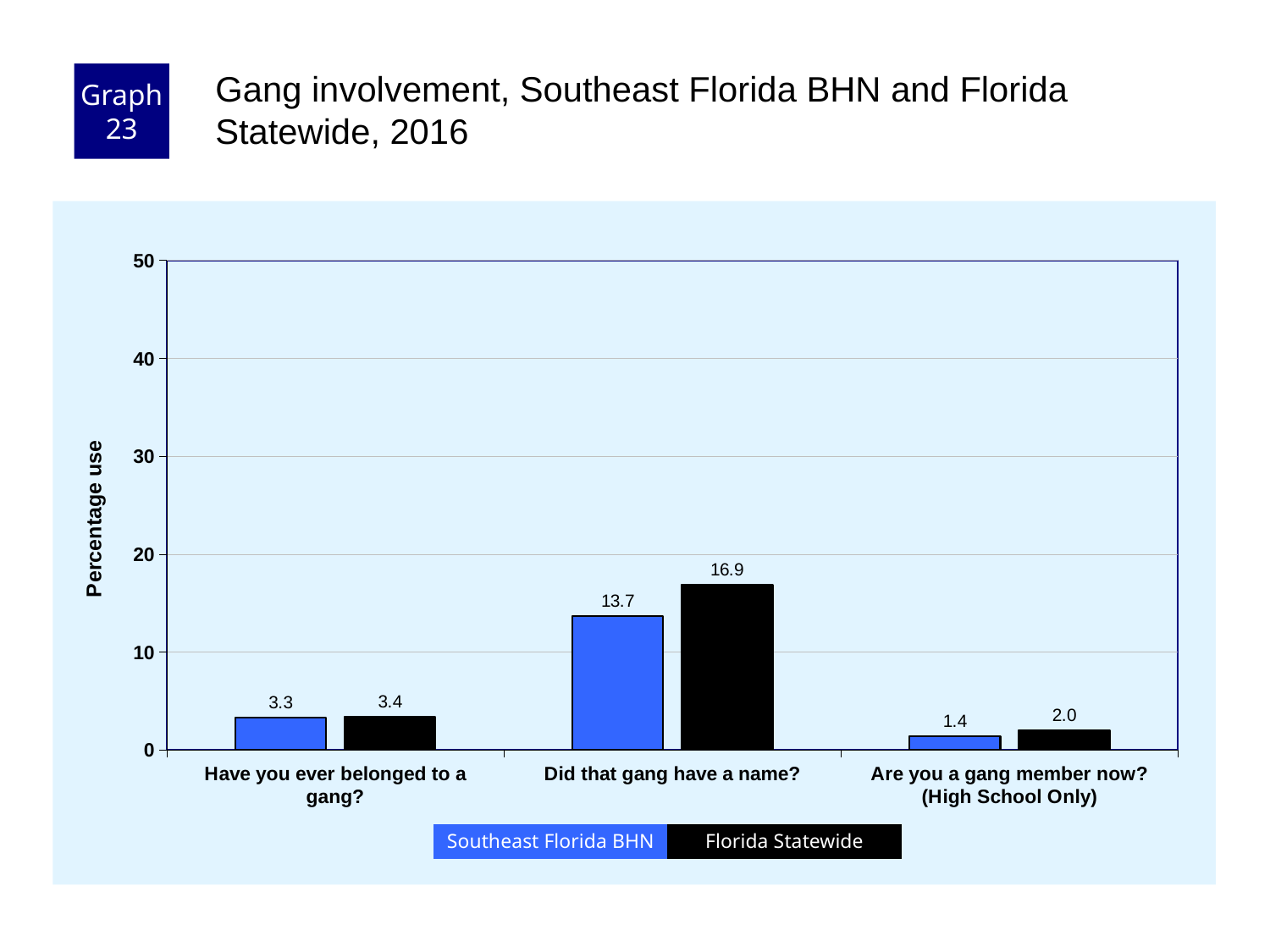
What is the label of the y axis? Percentage use How many series does the legend list? 2 Which category has the highest Florida Statewide value? Did that gang have a name? Which category has the lowest Southeast Florida BHN value? Are you a gang member now? (High School Only) What is the difference between the Florida Statewide and Southeast Florida BHN values for "Did that gang have a name?"? 3.2 What is the Florida Statewide value for "Are you a gang member now? (High School Only)"? 2.0 What is the Florida Statewide value for "Have you ever belonged to a gang?"? 3.4 What is the Southeast Florida BHN value for "Did that gang have a name?"? 13.7 How many categories are shown on the x axis? 3 What kind of chart is shown on the slide? bar chart For "Are you a gang member now? (High School Only)", which series has the larger value, Southeast Florida BHN or Florida Statewide? Florida Statewide Is the Florida Statewide value for "Did that gang have a name?" greater or less than 20? less